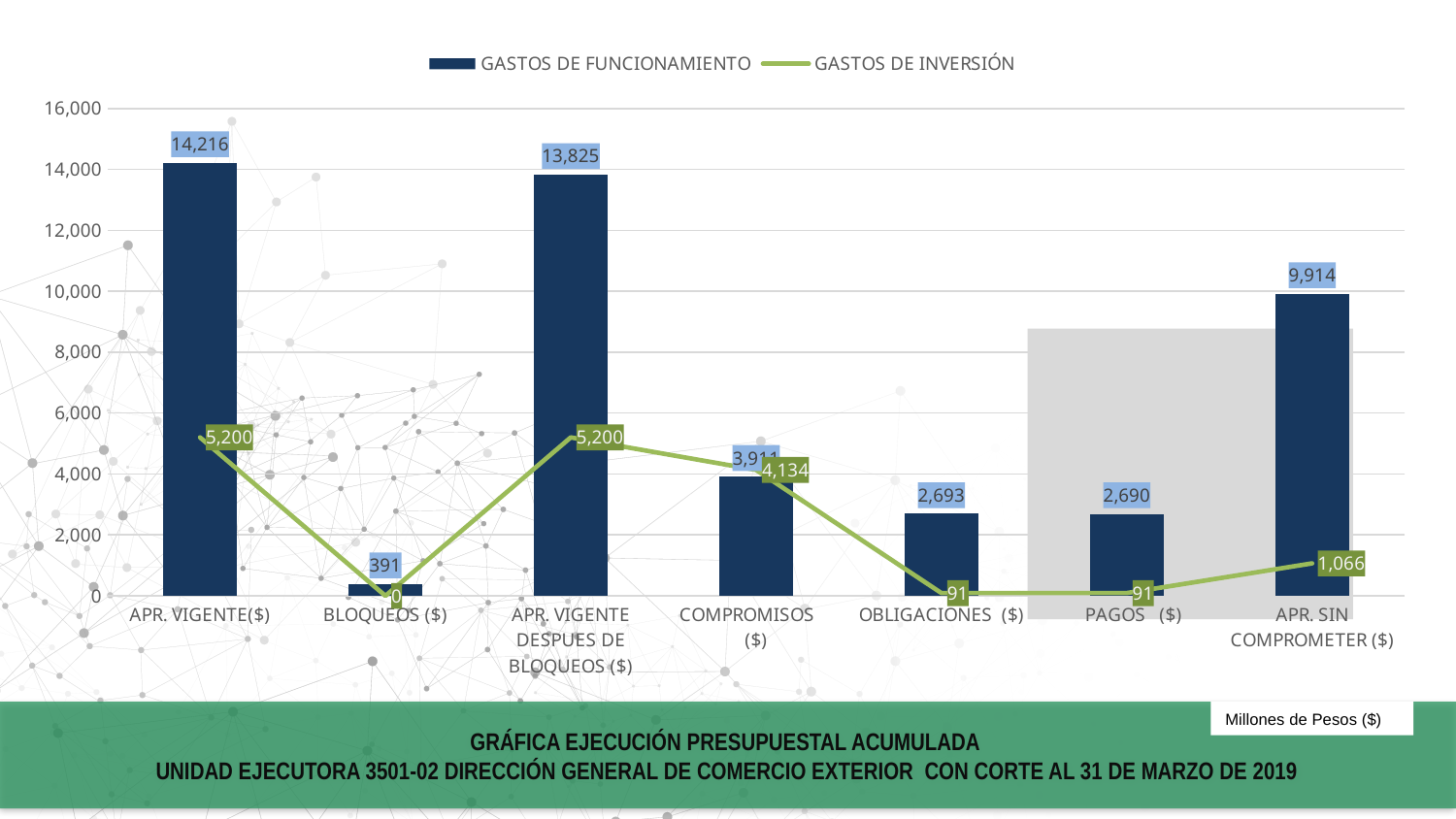
What is the value of GASTOS DE FUNCIONAMIENTO for APR. SIN COMPROMETER ($)? 9,914 What is the difference between GASTOS DE FUNCIONAMIENTO for APR. VIGENTE($) and APR. VIGENTE DESPUES DE BLOQUEOS ($)? 391 What is the value of GASTOS DE INVERSIÓN for COMPROMISOS ($)? 4,134 Which is larger: GASTOS DE FUNCIONAMIENTO for COMPROMISOS ($) or GASTOS DE INVERSIÓN for COMPROMISOS ($)? GASTOS DE INVERSIÓN Which category has the highest GASTOS DE FUNCIONAMIENTO value? APR. VIGENTE($) What is the value of GASTOS DE INVERSIÓN for BLOQUEOS ($)? 0 Is the GASTOS DE FUNCIONAMIENTO value for OBLIGACIONES ($) greater or less than 4,000? less What is the value of GASTOS DE FUNCIONAMIENTO for APR. VIGENTE($)? 14,216 How many series does the legend list? 2 How many categories are shown on the x axis? 7 Which series is drawn as a line? GASTOS DE INVERSIÓN Which category has the lowest GASTOS DE FUNCIONAMIENTO value? BLOQUEOS ($)